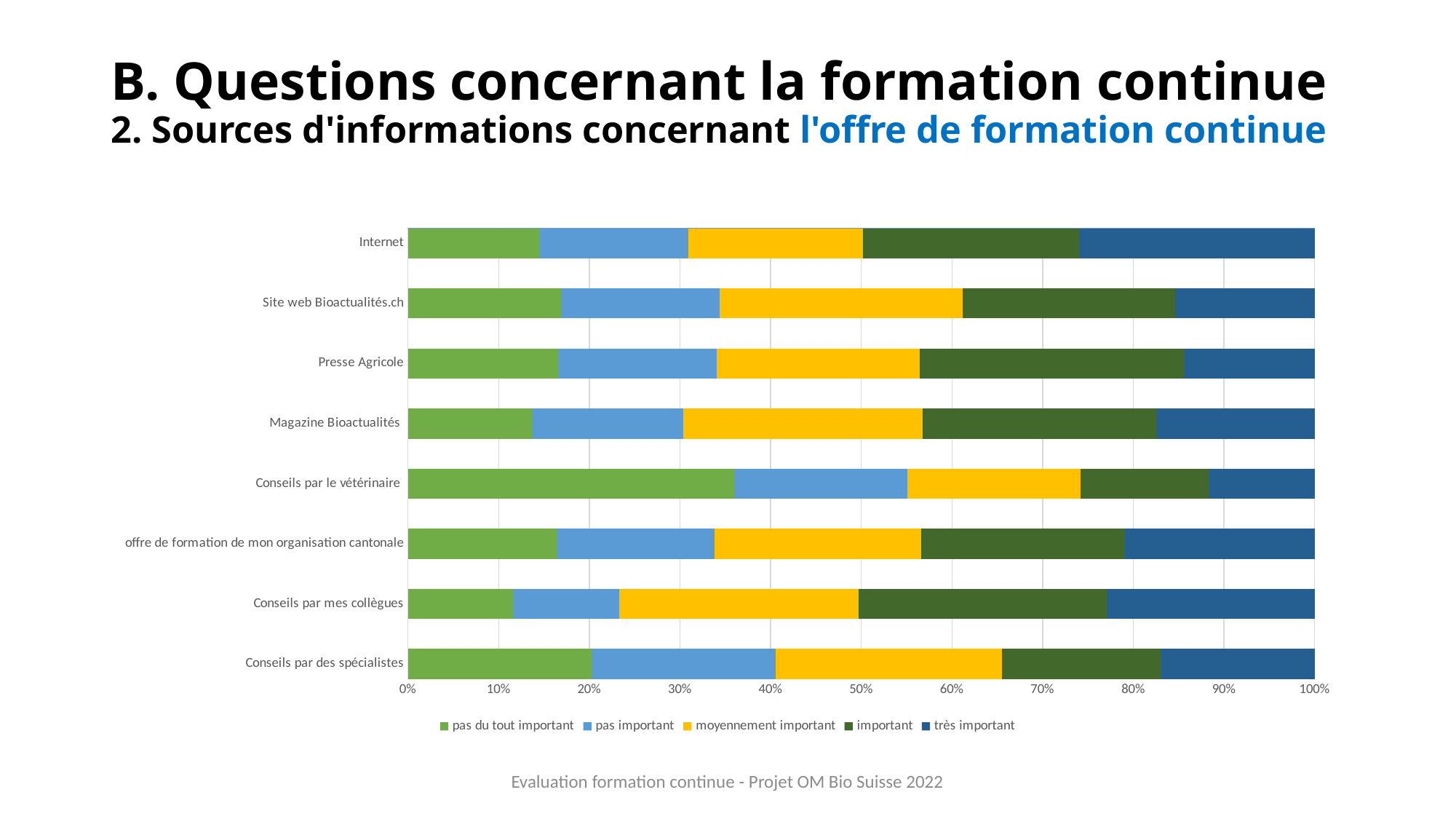
Which is larger: the 'pas du tout important' share for Conseils par le vétérinaire or for Internet? Conseils par le vétérinaire Which series is shown in yellow in the legend? moyennement important Is the 'pas du tout important' share for Conseils par mes collègues greater or less than 20%? less What kind of chart is shown on the slide? stacked bar chart How many information sources (categories) are plotted on the chart? 8 Is the 'pas du tout important' share for Conseils par le vétérinaire greater or less than 30%? greater Is the 'pas du tout important' share for Internet greater or less than 20%? less How many series does the chart legend list? 5 Which is larger: the 'important' share for Conseils par mes collègues or for Conseils par le vétérinaire? Conseils par mes collègues What is the maximum value shown on the horizontal axis? 100% Which category has the largest 'pas du tout important' segment? Conseils par le vétérinaire